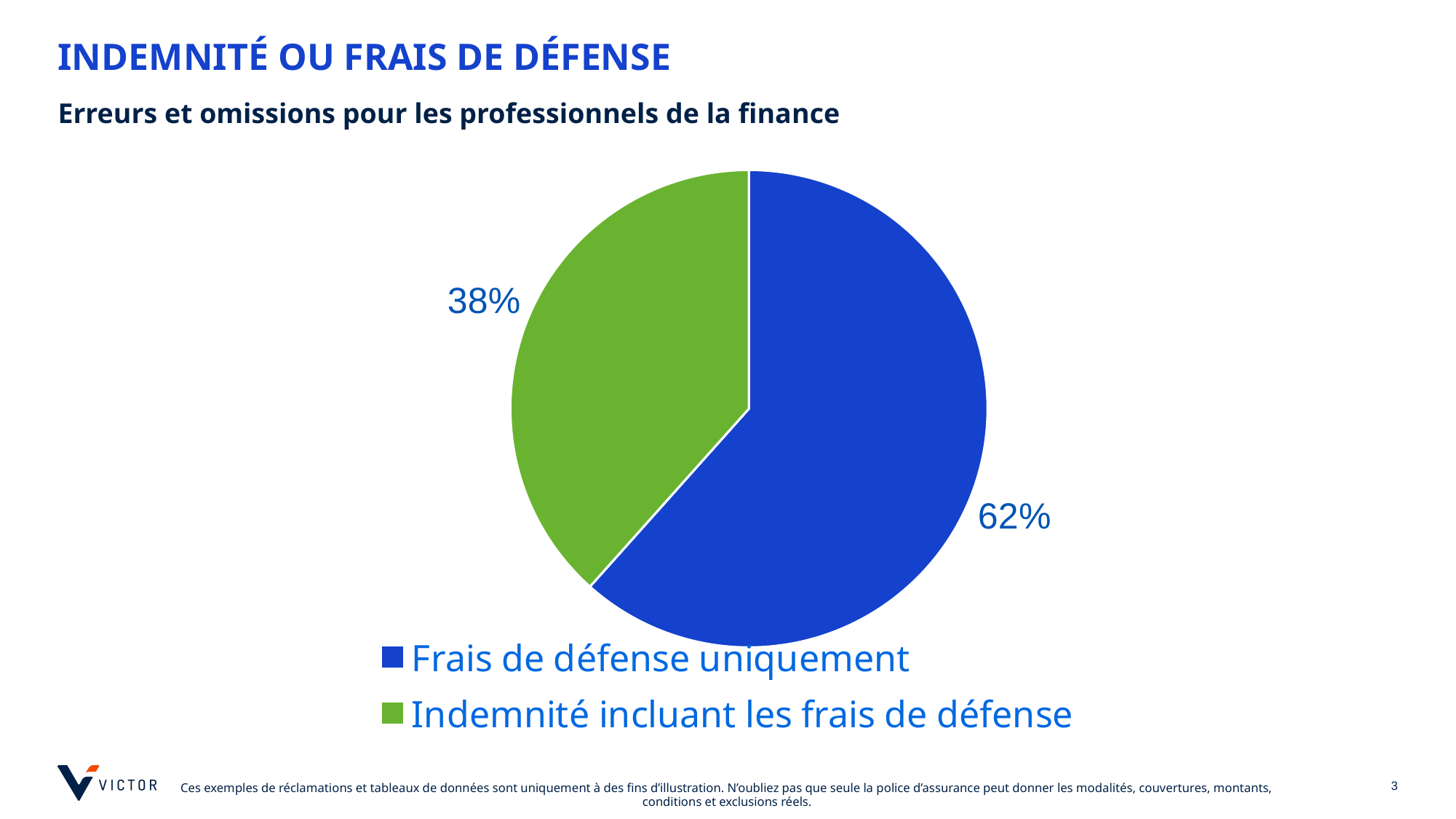
Which slice is the smallest? Indemnité incluant les frais de défense How many slices does the pie chart have? 2 How many entries does the legend list? 2 Which slice is the largest? Frais de défense uniquement What colour is the 'Indemnité incluant les frais de défense' slice? green What is the difference in percentage points between 'Frais de défense uniquement' and 'Indemnité incluant les frais de défense'? 24 What share of the pie is 'Indemnité incluant les frais de défense'? 38% Is the share for 'Frais de défense uniquement' greater or less than 50%? greater What kind of chart is shown on the slide? pie chart Which is larger: 'Frais de défense uniquement' or 'Indemnité incluant les frais de défense'? Frais de défense uniquement What is the title of the slide containing the chart? INDEMNITÉ OU FRAIS DE DÉFENSE What share of the pie is 'Frais de défense uniquement'? 62%